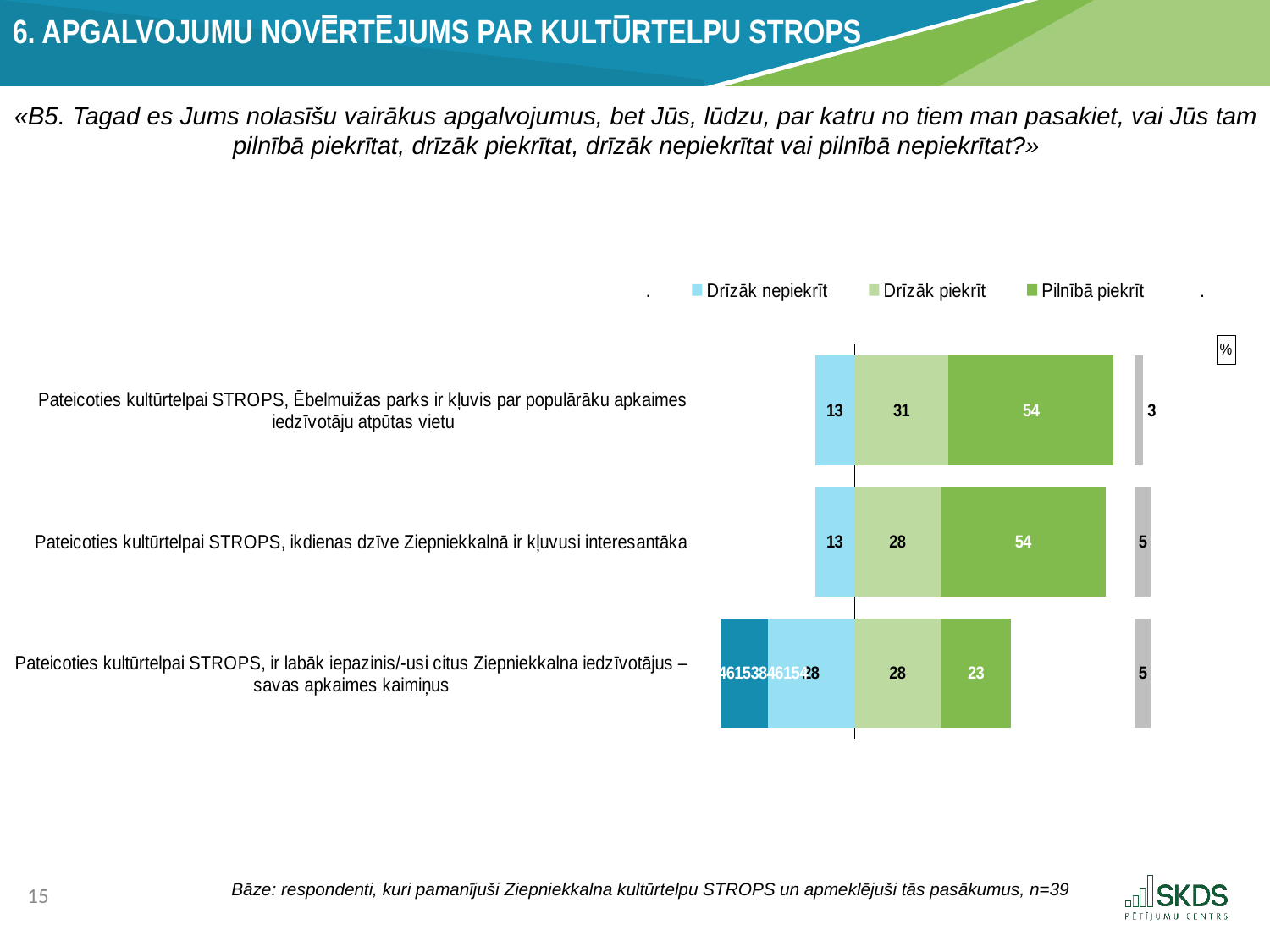
What is the "Drīzāk piekrīt" value for the statement that everyday life in Ziepniekkalns has become more interesting? 28 Which statement has the larger "Drīzāk piekrīt" value: the Ēbelmuižas parks statement or the everyday life in Ziepniekkalns statement? The Ēbelmuižas parks statement What is the "Drīzāk piekrīt" value for the statement about Ēbelmuižas parks becoming a more popular recreation place? 31 What percentage of respondents answered "Pilnībā piekrīt" to the statement that Ēbelmuižas parks has become a more popular recreation place? 54 Which statement has the lowest "Pilnībā piekrīt" value? Pateicoties kultūrtelpai STROPS, ir labāk iepazinis/-usi citus Ziepniekkalna iedzīvotājus – savas apkaimes kaimiņus What is the "Pilnībā piekrīt" value for the statement about getting to know other Ziepniekkalns residents (neighbours) better? 23 How many statements are shown in the chart? 3 What is the difference between the "Drīzāk piekrīt" and "Drīzāk nepiekrīt" values for the Ēbelmuižas parks statement? 18 What kind of chart is shown on the slide? Stacked bar chart What value is printed in the grey segment at the right end of the bar for the Ēbelmuižas parks statement? 3 What is the difference between the "Pilnībā piekrīt" values for the Ēbelmuižas parks statement and the neighbours statement? 31 What is the "Drīzāk nepiekrīt" value for the statement that everyday life in Ziepniekkalns has become more interesting? 13